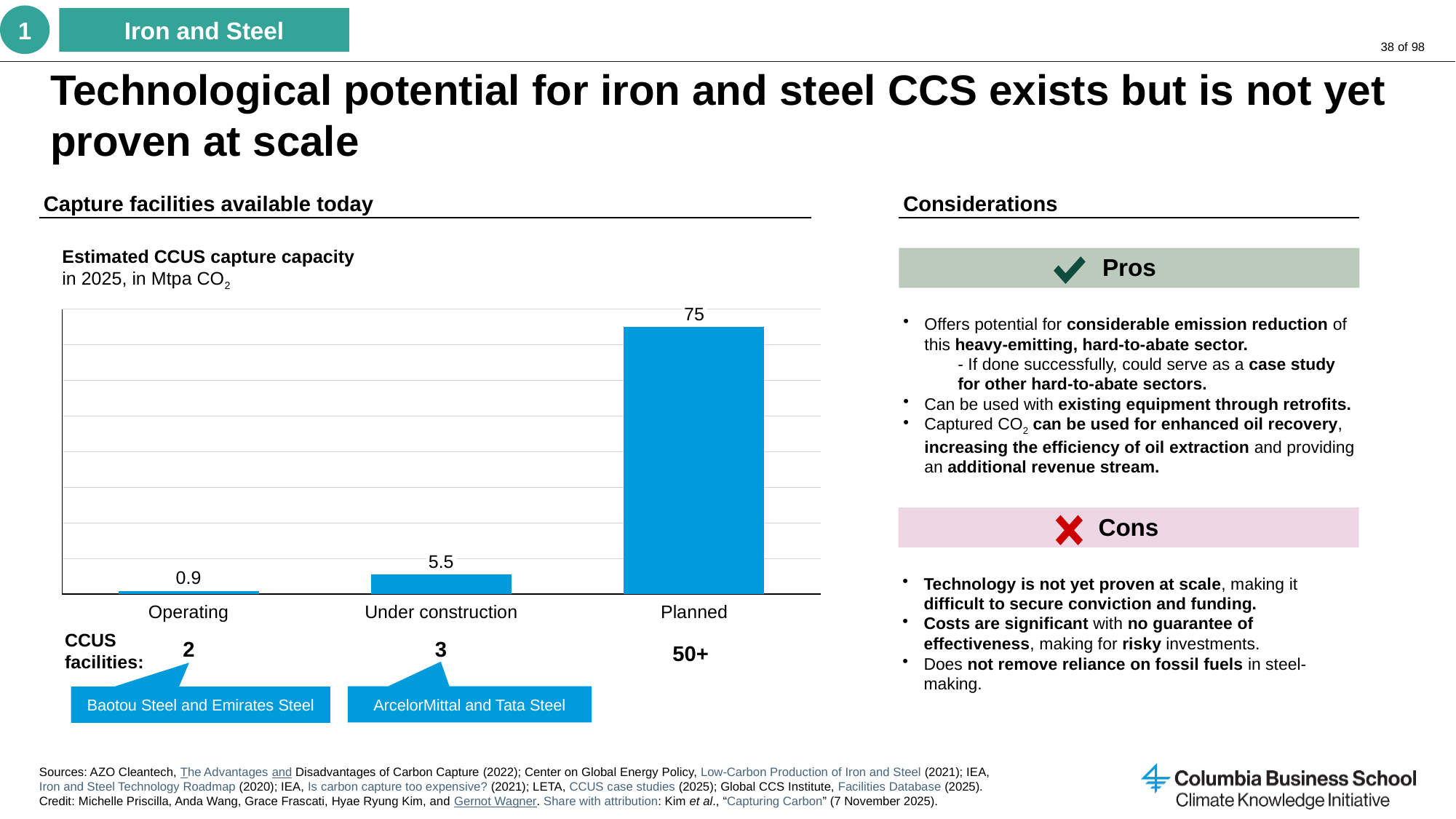
Which category has the highest estimated CCUS capture capacity? Planned What kind of chart is used to show estimated CCUS capture capacity? Bar chart Do the values rise or fall moving from Operating to Planned along the x axis? Rise Which has a larger capture capacity, Operating or Under construction? Under construction What is the estimated CCUS capture capacity for Operating facilities? 0.9 In what unit is the estimated CCUS capture capacity expressed in the chart? Mtpa CO2 What is the estimated CCUS capture capacity for Planned facilities? 75 What is the estimated CCUS capture capacity for facilities Under construction? 5.5 Which category has the lowest estimated CCUS capture capacity? Operating What is the difference in capture capacity between Planned and Under construction? 69.5 How many categories are shown on the x axis of the chart? 3 What is the difference in capture capacity between Under construction and Operating? 4.6